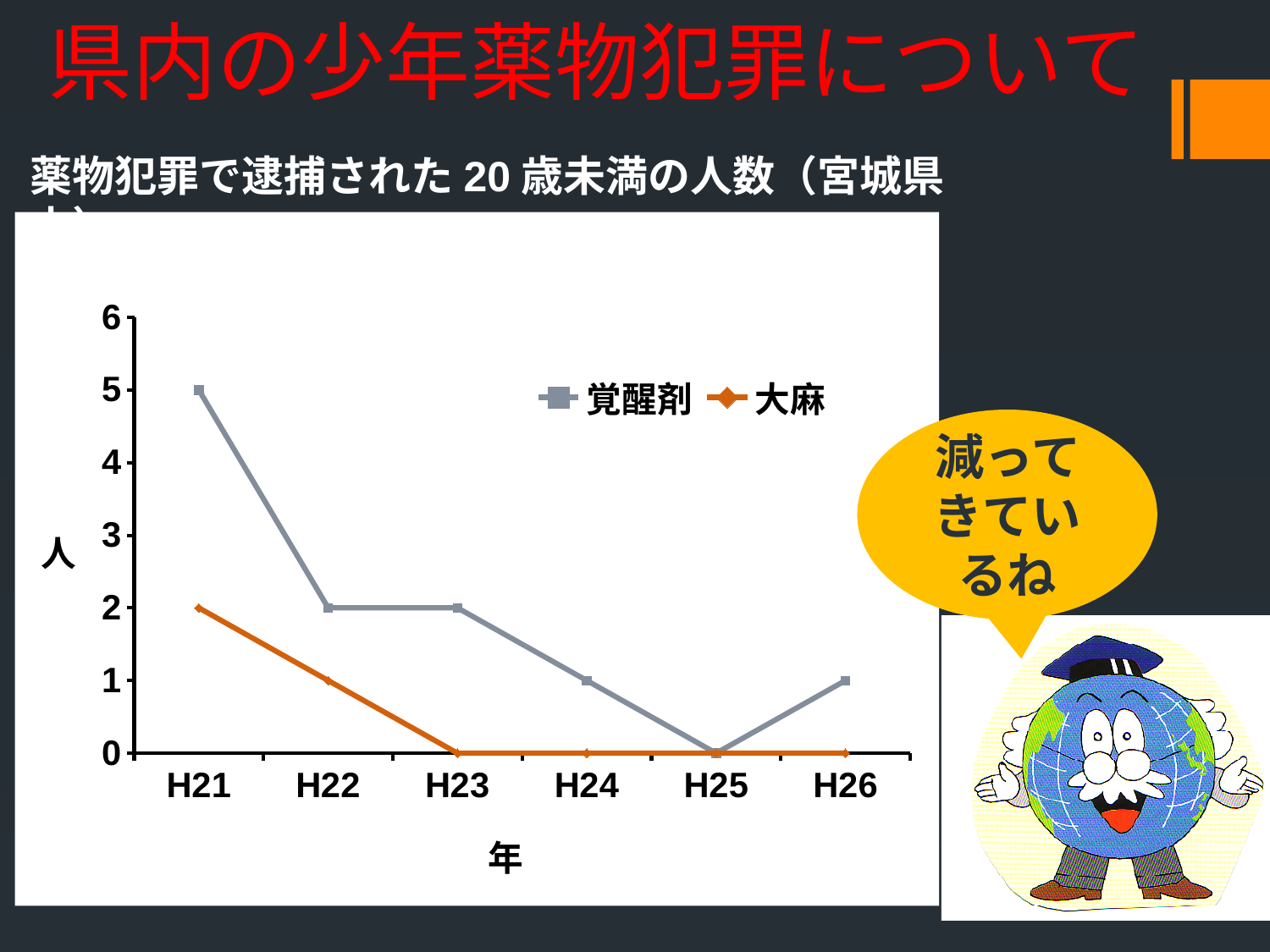
Does the value for 大麻 rise or fall from H21 to H23? fall How many series does the legend list? 2 What is the value for 大麻 in H21? 2 In which year is the value for 覚醒剤 highest? H21 What is the difference between 覚醒剤 and 大麻 in H21? 3 What is the value for 覚醒剤 in H21? 5 How many years are shown on the x axis? 6 What is the value for 大麻 in H23? 0 What is the value for 覚醒剤 in H24? 1 Which is larger in H22, 覚醒剤 or 大麻? 覚醒剤 What kind of chart is shown on the slide? line chart In which year is the value for 覚醒剤 lowest? H25